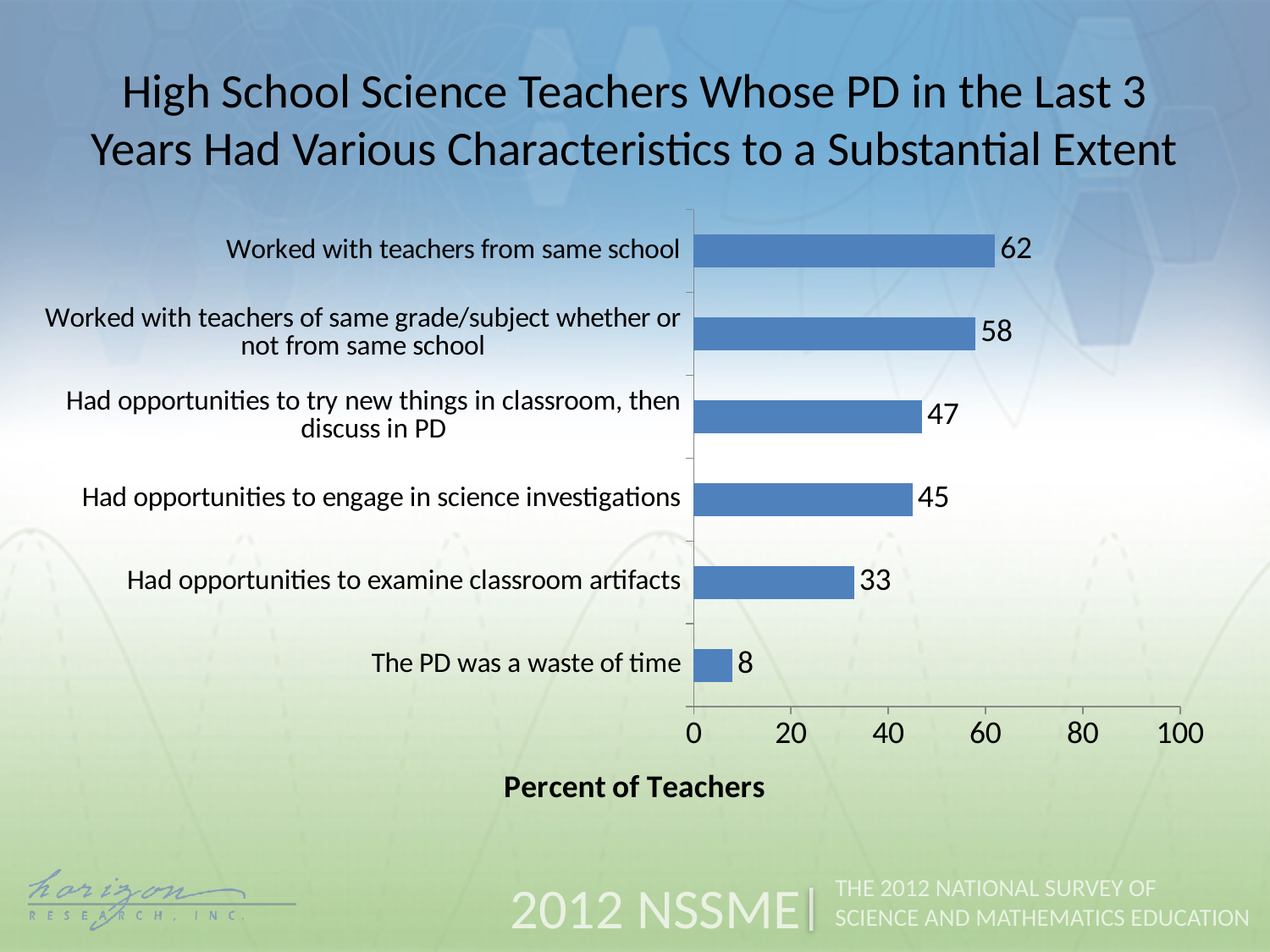
Is the value for 'Had opportunities to try new things in classroom, then discuss in PD' greater or less than 40? greater Which category has the highest value? Worked with teachers from same school What percent of teachers reported that the PD was a waste of time? 8 What is the difference between 'Worked with teachers of same grade/subject whether or not from same school' and 'Had opportunities to try new things in classroom, then discuss in PD'? 11 What is the difference between 'Worked with teachers from same school' and 'Had opportunities to examine classroom artifacts'? 29 What kind of chart is shown on the slide? Bar chart What percent of teachers worked with teachers from the same school? 62 Which category has the lowest value? The PD was a waste of time What is the label of the horizontal axis? Percent of Teachers Which is larger: 'Had opportunities to examine classroom artifacts' or 'Had opportunities to engage in science investigations'? Had opportunities to engage in science investigations How many categories are shown in the chart? 6 What is the value for 'Had opportunities to engage in science investigations'? 45